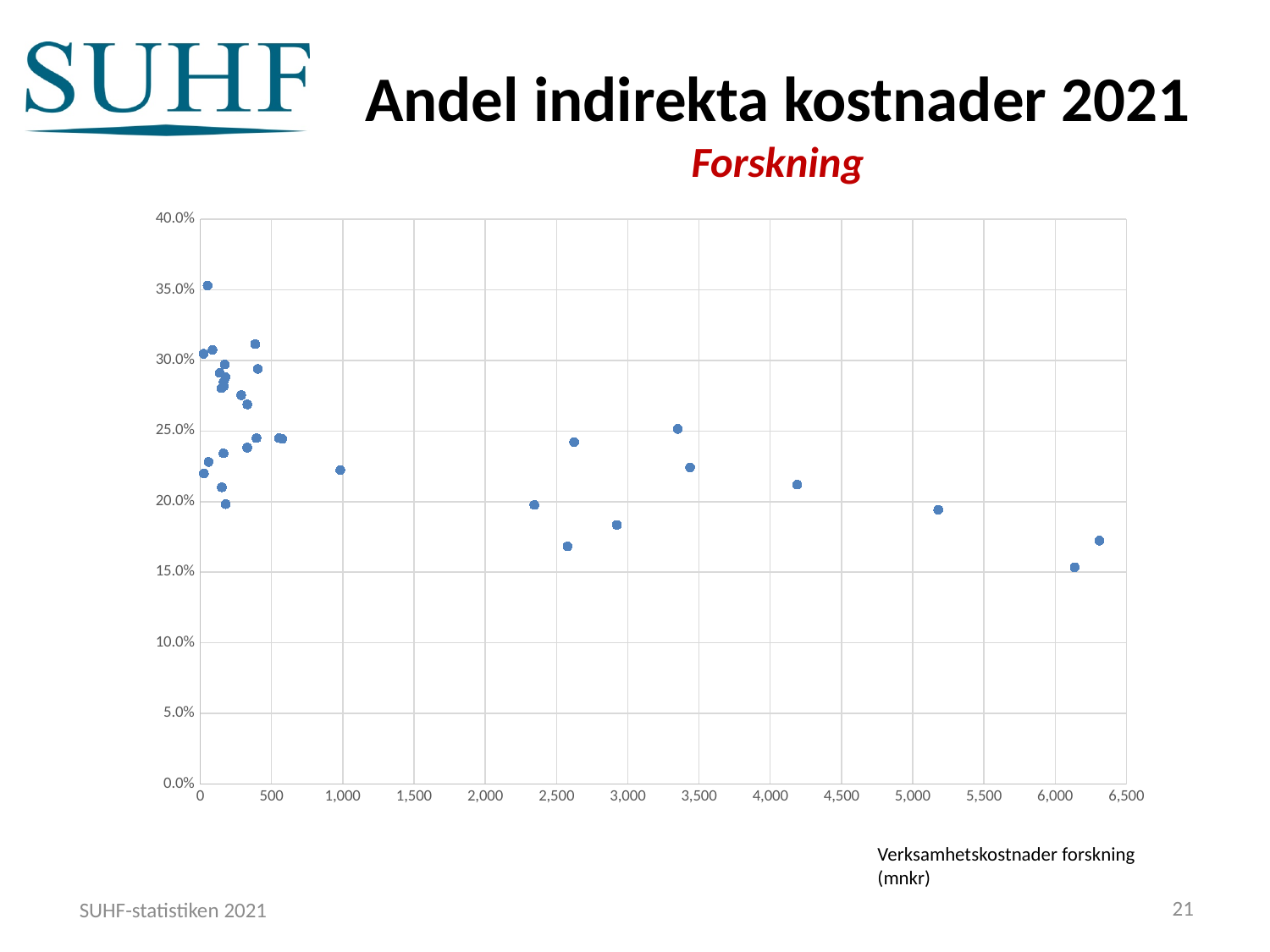
How many points are plotted beyond 4,000 on the horizontal axis? 4 Do the plotted values generally rise or fall as the horizontal axis value increases? fall What kind of chart is shown on the slide? scatter chart Is the value for the point near 6,100 on the x axis greater or less than 20.0%? less What is the title of the chart on the slide? Andel indirekta kostnader 2021 Which point has the higher value: the one near 6,100 on the x axis or the one near 6,300 on the x axis? the one near 6,300 Is the value for the rightmost point (near 6,300 on the x axis) greater or less than 20.0%? less Is the value for the point near 3,350 on the x axis greater or less than 20.0%? greater What is the maximum value shown on the vertical axis? 40.0% What label is given for the horizontal axis of the chart? Verksamhetskostnader forskning (mnkr)